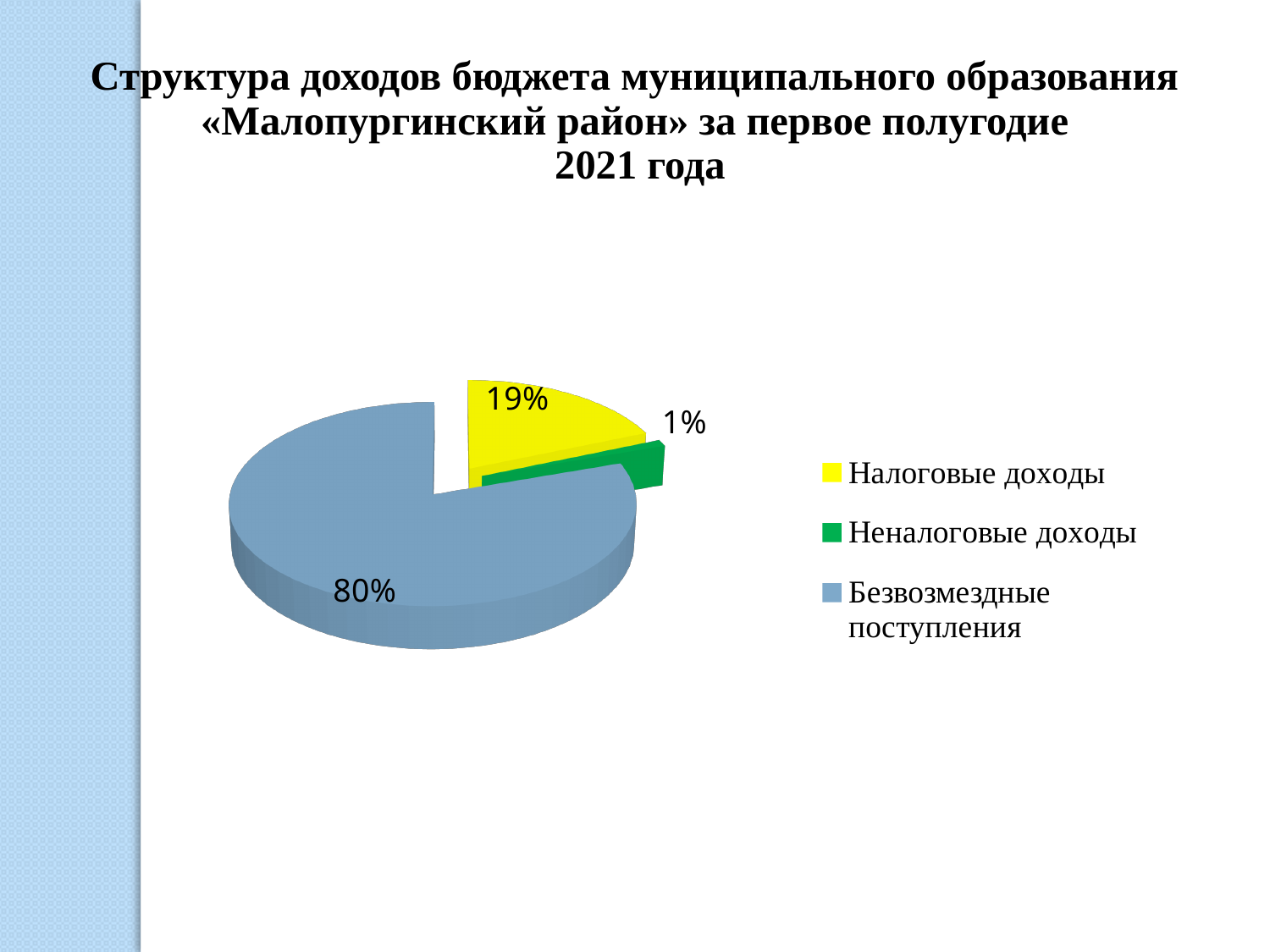
What share of the pie does Безвозмездные поступления represent? 80% What colour is the slice for Налоговые доходы? Yellow How many categories are shown in the pie chart? 3 Which category has the smallest share of the pie? Неналоговые доходы What is the difference in percentage points between Безвозмездные поступления and Налоговые доходы? 61 Which is larger: the share for Налоговые доходы or the share for Неналоговые доходы? Налоговые доходы What kind of chart is shown on the slide? Pie chart What is the difference in percentage points between Налоговые доходы and Неналоговые доходы? 18 Which category is shown in green in the legend? Неналоговые доходы Which category has the largest share of the pie? Безвозмездные поступления What share of the pie does Неналоговые доходы represent? 1% What share of the pie does Налоговые доходы represent? 19%